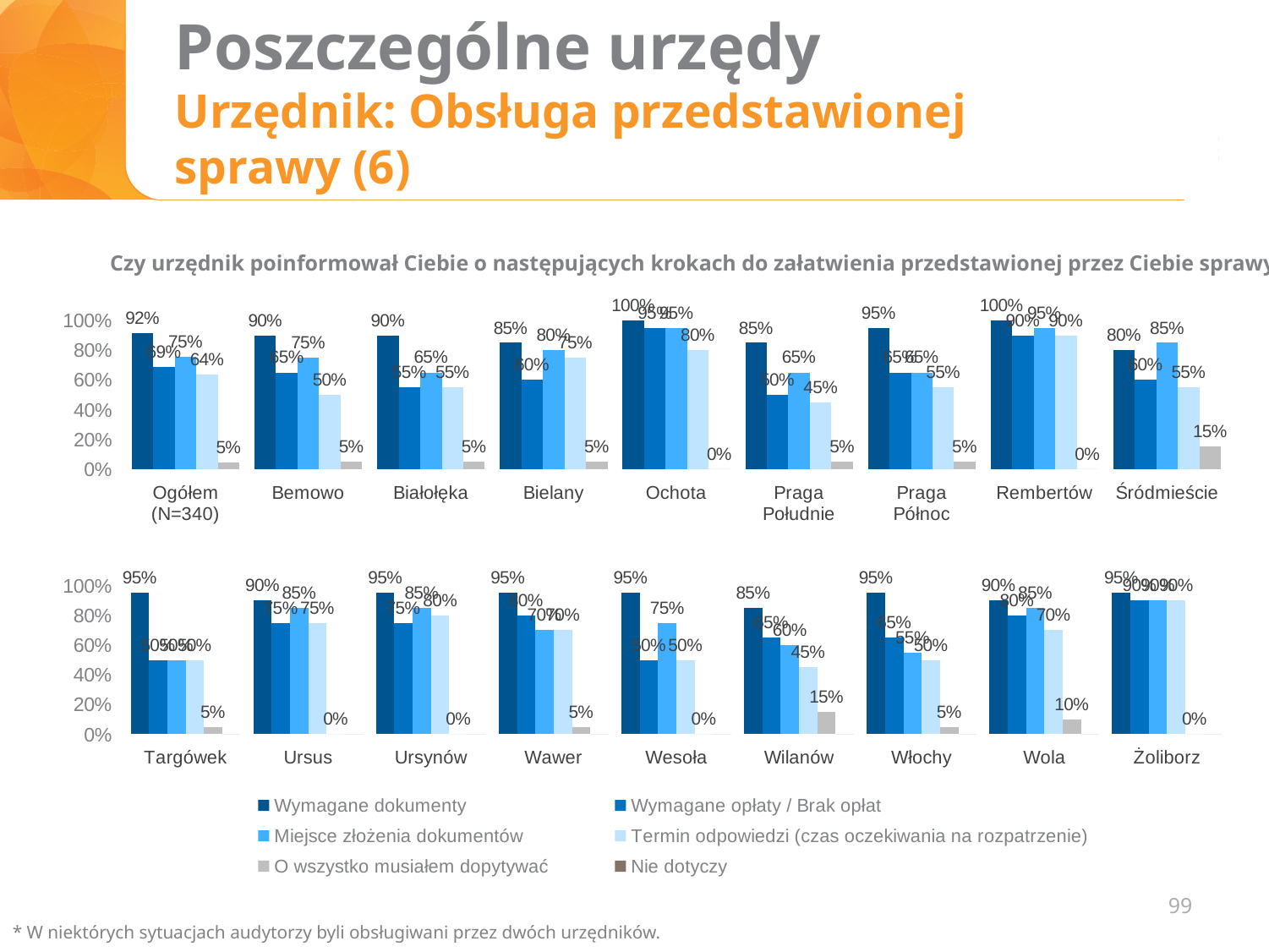
In the bottom chart, what is the value of O wszystko musiałem dopytywać for Wola? 10% In the bottom chart, which is larger: the O wszystko musiałem dopytywać value for Wola or for Wilanów? Wilanów In the top chart, how many categories (districts, including Ogółem) are shown? 9 In the top chart, what is the value of Wymagane dokumenty for Ogółem (N=340)? 92% In the top chart, which category has the highest value for O wszystko musiałem dopytywać? Śródmieście In the top chart, which district has the lowest value for Wymagane dokumenty? Śródmieście In the top chart, what is the value of O wszystko musiałem dopytywać for Śródmieście? 15% How many series does the legend list? 6 In the bottom chart, what is the value of Wymagane dokumenty for Wilanów? 85% What kind of chart is used on this slide? bar chart In the bottom chart, which district has the lowest value for Wymagane dokumenty? Wilanów In the top chart, what is the difference between the O wszystko musiałem dopytywać values for Śródmieście and Ogółem (N=340)? 10 percentage points